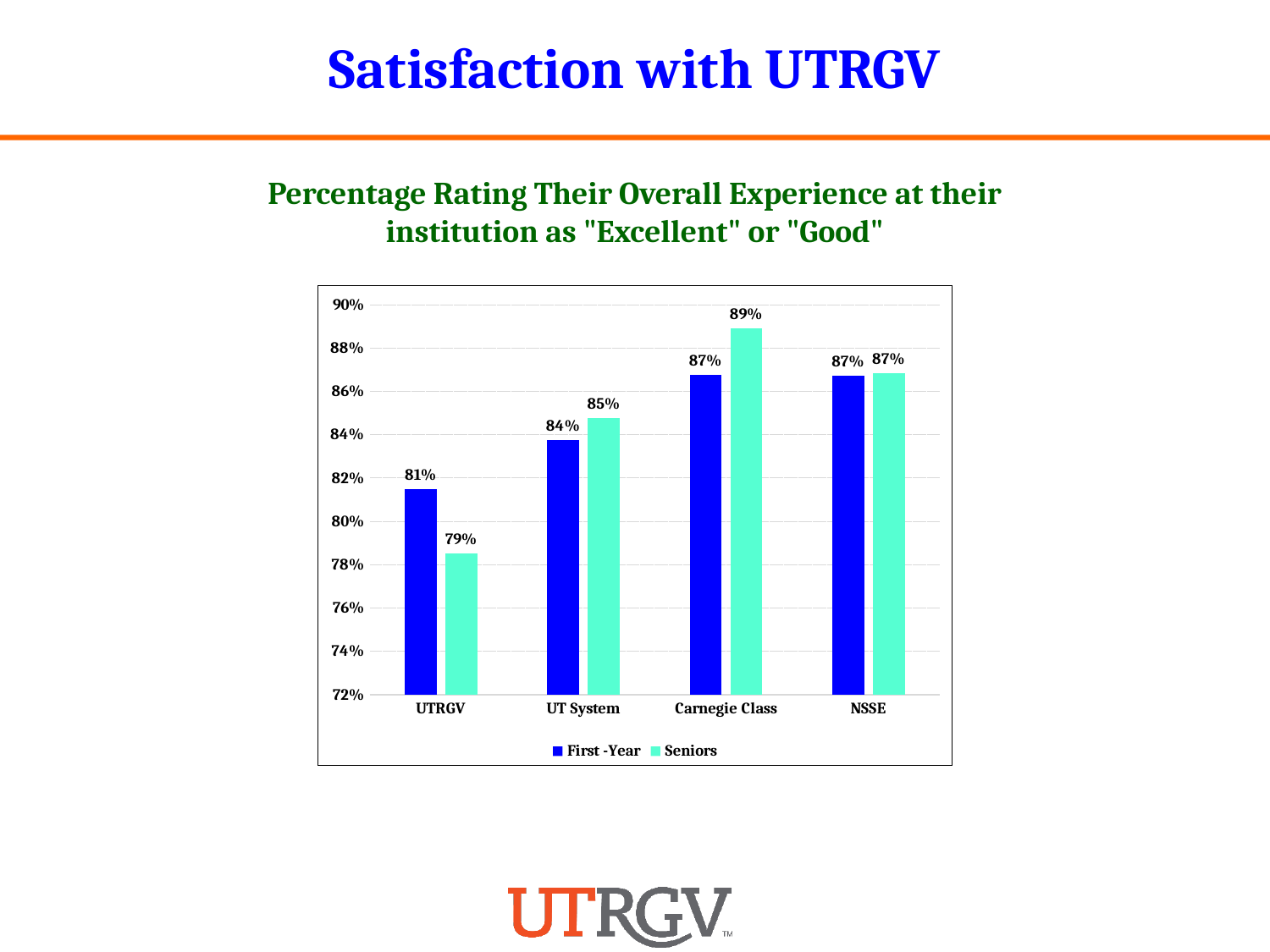
Which is larger for UTRGV: the First-Year value or the Seniors value? First-Year Is the First-Year value for UT System greater or less than 82%? greater Which category has the lowest Seniors value? UTRGV What is the Seniors value for Carnegie Class? 89% What colour are the Seniors bars? Light teal (aqua) What is the Seniors value for UT System? 85% What is the difference between the Seniors value for Carnegie Class and the Seniors value for UTRGV? 10% Which category has the highest Seniors value? Carnegie Class What percentage of First-Year students at UTRGV rated their overall experience as "Excellent" or "Good"? 81% How many series does the legend list? 2 What kind of chart is shown on the slide? Bar chart How many categories are shown on the x axis? 4